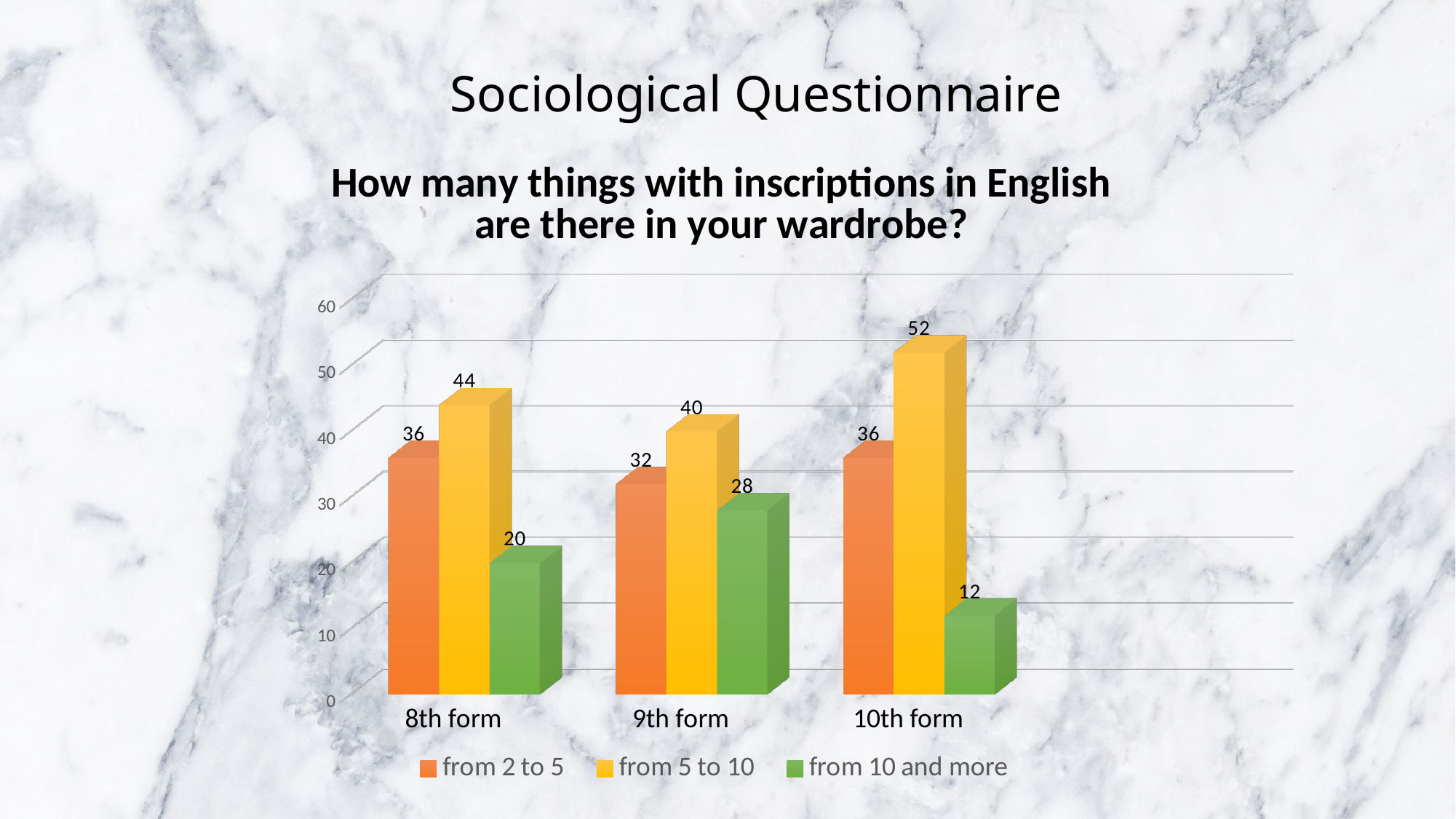
How many series does the legend list? 3 What is the difference between the 'from 5 to 10' value and the 'from 2 to 5' value in the 10th form? 16 What is the value for 'from 5 to 10' in the 8th form? 44 Which form has the lowest value for 'from 10 and more'? 10th form Does the 'from 2 to 5' value rise or fall from the 8th form to the 9th form? fall What is the value for 'from 10 and more' in the 10th form? 12 What colour represents the 'from 10 and more' series? green What kind of chart is shown on the slide? bar chart What is the value for 'from 2 to 5' in the 9th form? 32 Which is larger in the 9th form: 'from 5 to 10' or 'from 10 and more'? from 5 to 10 Which form has the highest value for 'from 5 to 10'? 10th form How many forms (categories) are shown on the x axis? 3